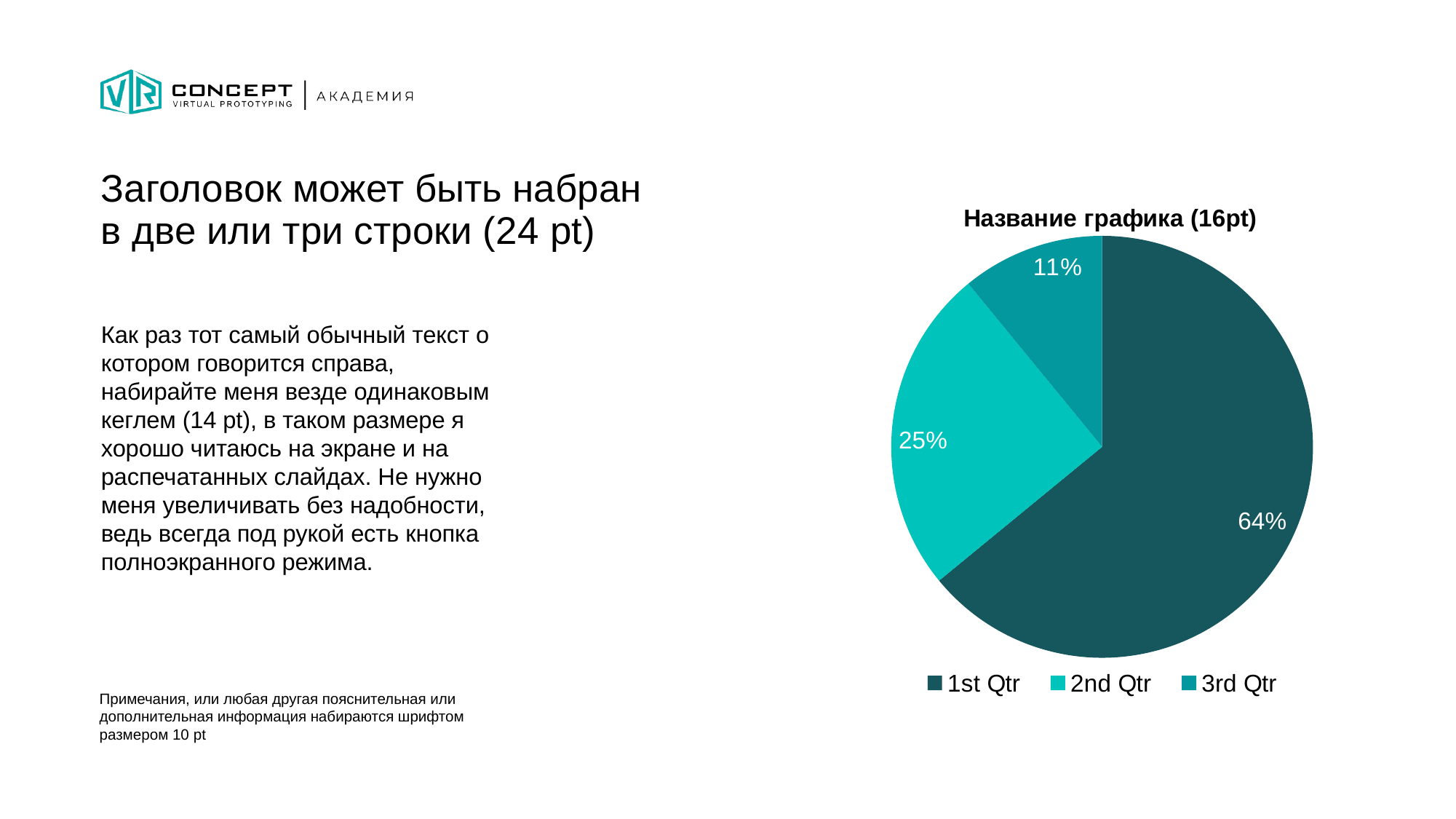
What is the difference in percentage points between the 2nd Qtr and 3rd Qtr slices? 14 What is the difference in percentage points between the 1st Qtr and 2nd Qtr slices? 39 What share of the pie does 1st Qtr represent? 64% What is the title of the chart? Название графика (16pt) How many slices does the pie chart have? 3 What kind of chart is shown on the slide? pie chart Which category has the smallest slice of the pie? 3rd Qtr Which slice is larger, 2nd Qtr or 3rd Qtr? 2nd Qtr What share of the pie does 2nd Qtr represent? 25% Which category has the largest slice of the pie? 1st Qtr What share of the pie does 3rd Qtr represent? 11% How many entries does the legend list? 3